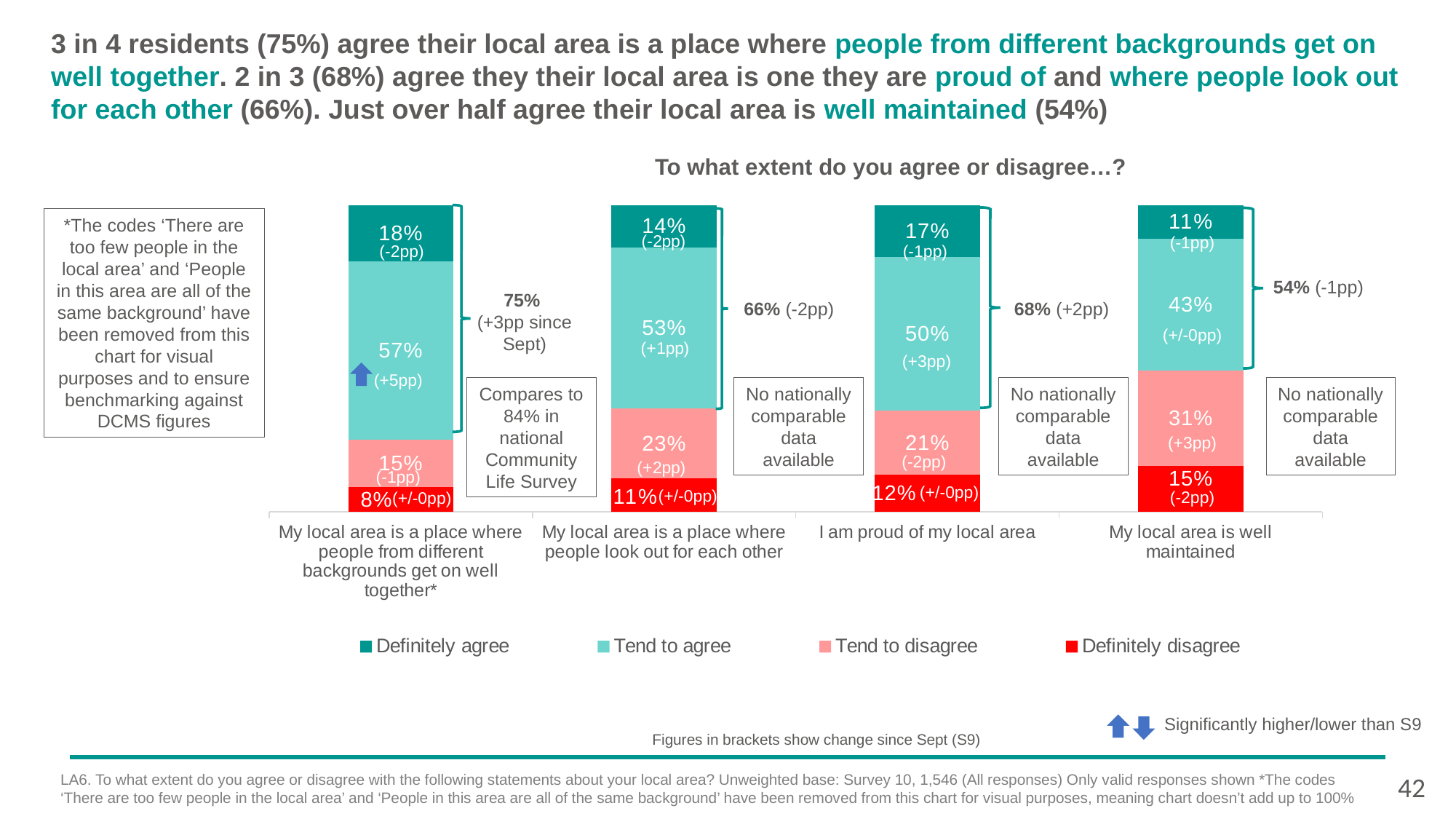
Which statement has the highest 'Definitely agree' percentage? My local area is a place where people from different backgrounds get on well together What kind of chart is shown on the slide? Stacked bar chart Which is larger: the 'Definitely disagree' percentage for 'I am proud of my local area' or for 'My local area is a place where people look out for each other'? I am proud of my local area What percentage of residents 'Tend to disagree' that their local area is a place where people look out for each other? 23% Which statement has the lowest 'Tend to agree' percentage? My local area is well maintained How many statements are shown on the x axis of the chart? 4 What percentage of residents 'Tend to agree' that their local area is a place where people from different backgrounds get on well together? 57% What percentage of residents 'Definitely agree' that they are proud of their local area? 17% What percentage of residents 'Definitely disagree' that their local area is well maintained? 15% How many series does the chart legend list? 4 What is the difference between the 'Tend to disagree' percentage for 'My local area is well maintained' and for 'I am proud of my local area'? 10 percentage points What is the combined agree percentage (Definitely agree plus Tend to agree) for 'My local area is a place where people look out for each other'? 66%